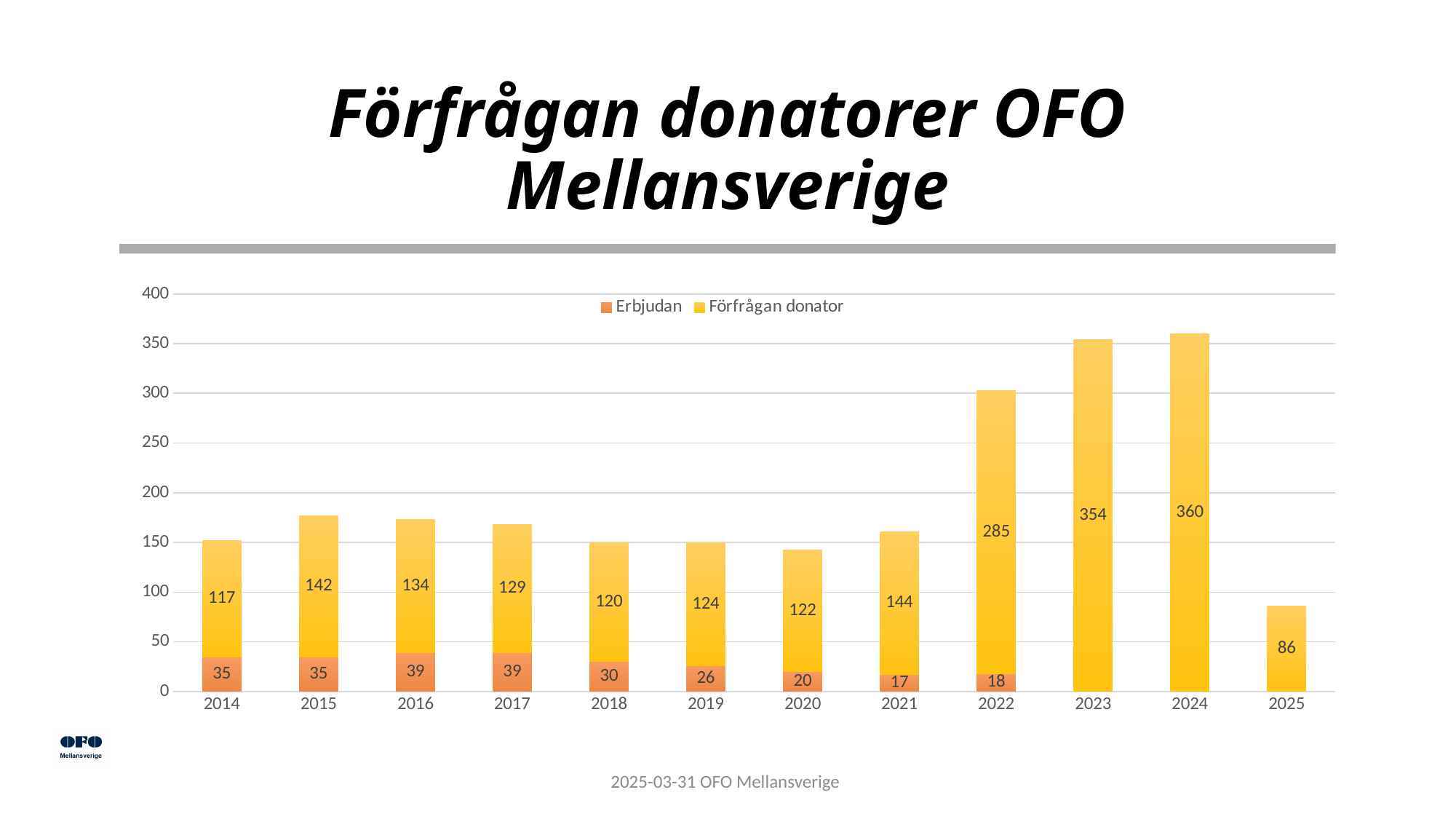
How many series does the legend list? 2 Which is larger, the Erbjudan value for 2016 or for 2018? 2016 What type of chart is shown on the slide? Stacked bar chart Which year has the highest Förfrågan donator value? 2024 What is the Erbjudan value for 2019? 26 What is the title of the chart on the slide? Förfrågan donatorer OFO Mellansverige What is the total of the stacked bar for 2014? 152 What is the difference between the Förfrågan donator values for 2024 and 2023? 6 What is the Förfrågan donator value for 2022? 285 Which year has the lowest Förfrågan donator value? 2025 Is the total of the stacked bar for 2022 greater or less than 300? greater How many years are shown on the x axis? 12